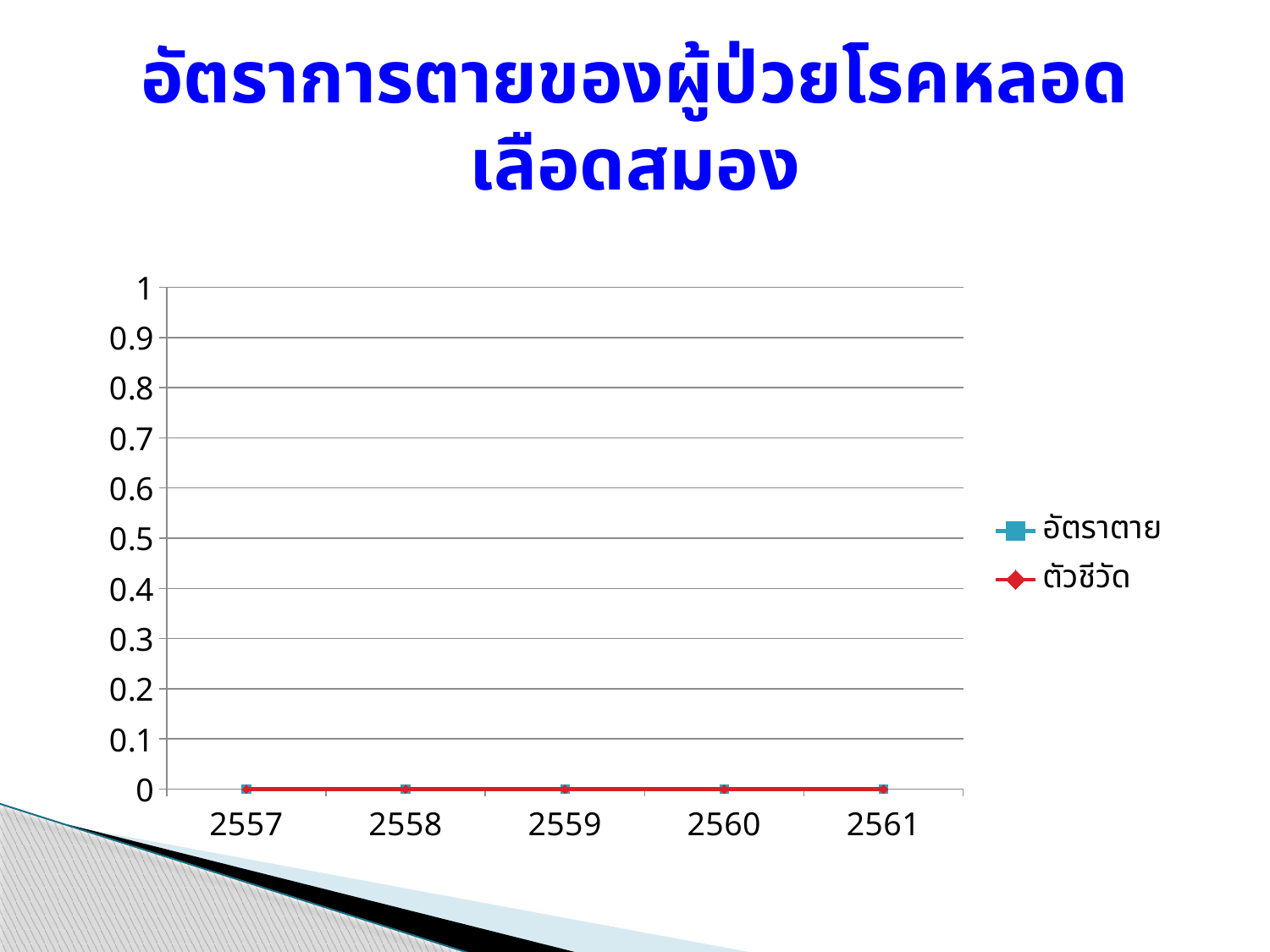
What is the value of อัตราตาย in 2559? 0 What is the value of อัตราตาย in 2557? 0 What is the value of ตัวชี้วัด in 2561? 0 How many series does the legend list? 2 What is the highest value shown on the y axis? 1 What is the difference between อัตราตาย and ตัวชี้วัด in 2558? 0 What is the first year shown on the x axis? 2557 What kind of chart is shown on the slide? line chart How many years are shown on the x axis? 5 Is the value for อัตราตาย in 2560 greater or less than 0.5? less Do the values of อัตราตาย rise, fall, or stay flat from 2557 to 2561? stay flat